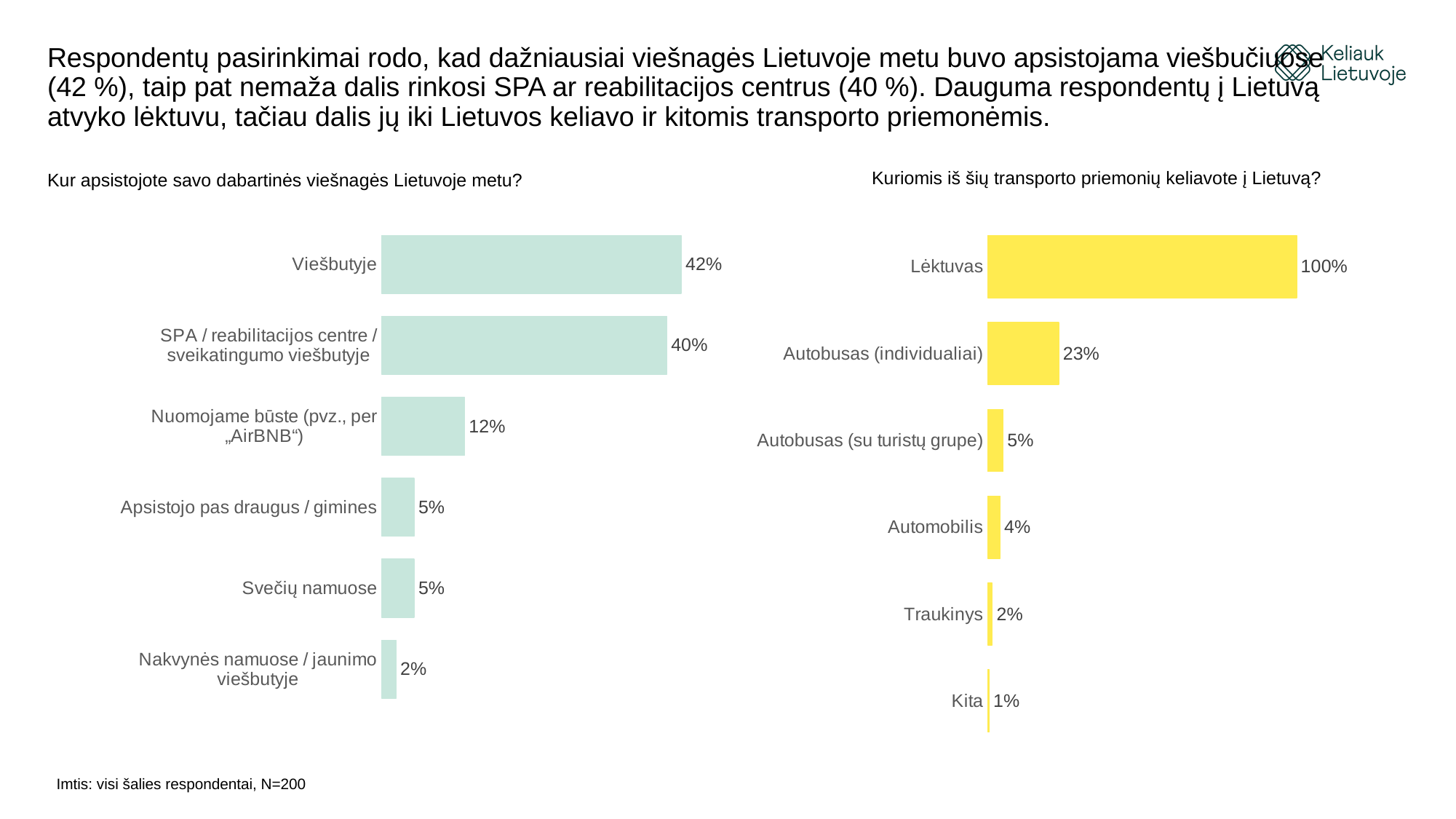
In the right chart (Kuriomis iš šių transporto priemonių keliavote į Lietuvą?), which category has the highest value? Lėktuvas In the right chart (Kuriomis iš šių transporto priemonių keliavote į Lietuvą?), how many categories are shown? 6 In the right chart (Kuriomis iš šių transporto priemonių keliavote į Lietuvą?), what is the value for Autobusas (individualiai)? 23% In the left chart (Kur apsistojote savo dabartinės viešnagės Lietuvoje metu?), what is the value for Nuomojame būste (pvz., per „AirBNB“)? 12% In the left chart (Kur apsistojote savo dabartinės viešnagės Lietuvoje metu?), what is the difference between Viešbutyje and SPA / reabilitacijos centre / sveikatingumo viešbutyje? 2% What type of chart is the left chart (Kur apsistojote savo dabartinės viešnagės Lietuvoje metu?)? Bar chart In the left chart (Kur apsistojote savo dabartinės viešnagės Lietuvoje metu?), what is the value for Viešbutyje? 42% In the right chart (Kuriomis iš šių transporto priemonių keliavote į Lietuvą?), what is the difference between Lėktuvas and Autobusas (individualiai)? 77% In the right chart (Kuriomis iš šių transporto priemonių keliavote į Lietuvą?), which is larger: Autobusas (su turistų grupe) or Automobilis? Autobusas (su turistų grupe) In the left chart (Kur apsistojote savo dabartinės viešnagės Lietuvoje metu?), which category has the lowest value? Nakvynės namuose / jaunimo viešbutyje In the right chart (Kuriomis iš šių transporto priemonių keliavote į Lietuvą?), what is the value for Traukinys? 2% In the left chart (Kur apsistojote savo dabartinės viešnagės Lietuvoje metu?), how many categories are shown? 6